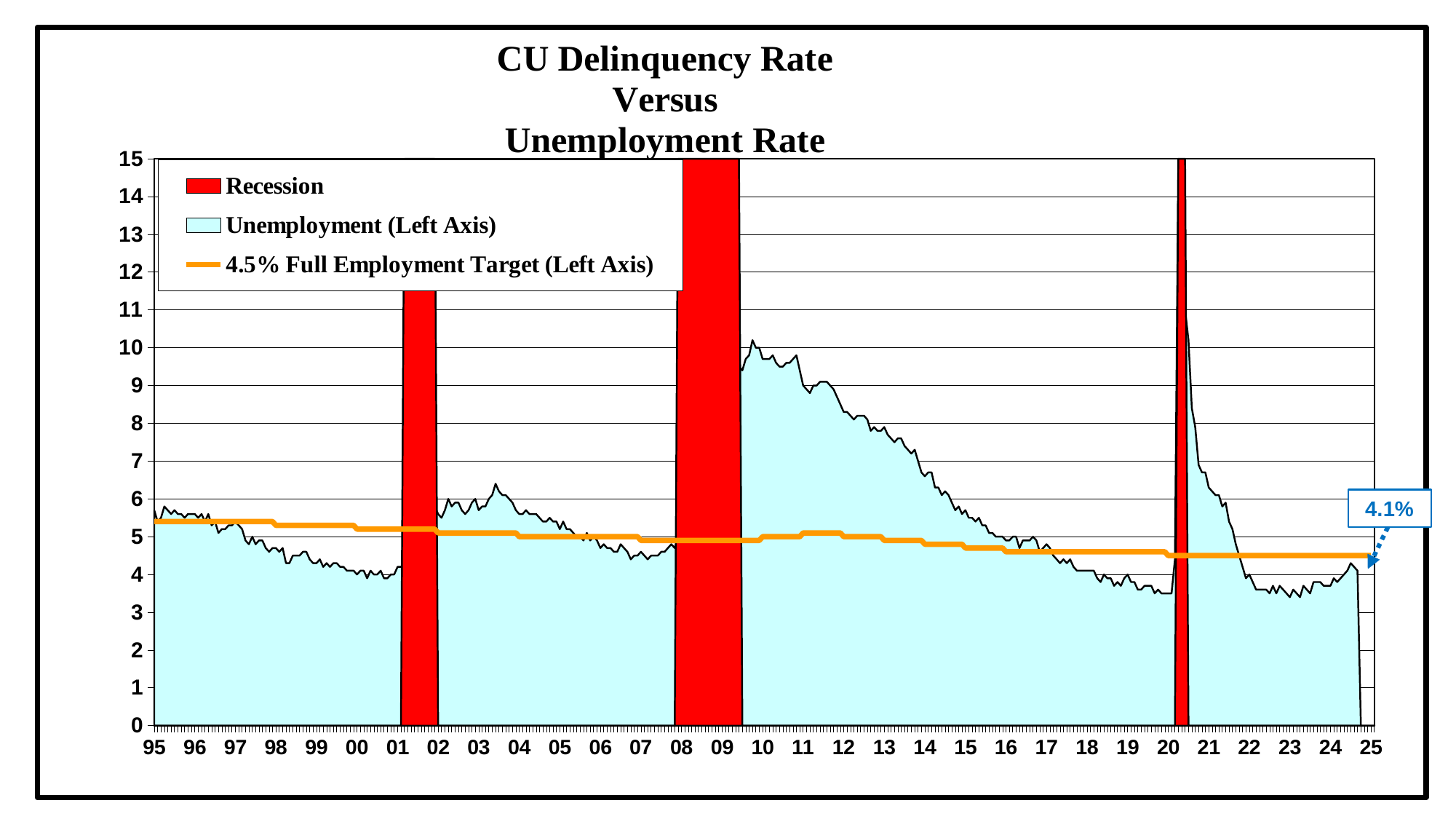
How many recession periods are shaded on the chart? 3 What is the most recent unemployment rate value labeled on the chart? 4.1% What kind of chart is this? area and line chart Is the unemployment rate in 2023 greater or less than 5? less Is the unemployment rate in 2003 greater or less than 5? greater What full employment target does the orange line represent? 4.5% What is the title of the chart? CU Delinquency Rate Versus Unemployment Rate Is the unemployment rate in 2010 greater or less than 9? greater How many series does the legend list? 3 What is the legend label for the orange line? 4.5% Full Employment Target (Left Axis) Does the unemployment rate rise or fall from 2010 to 2019? fall